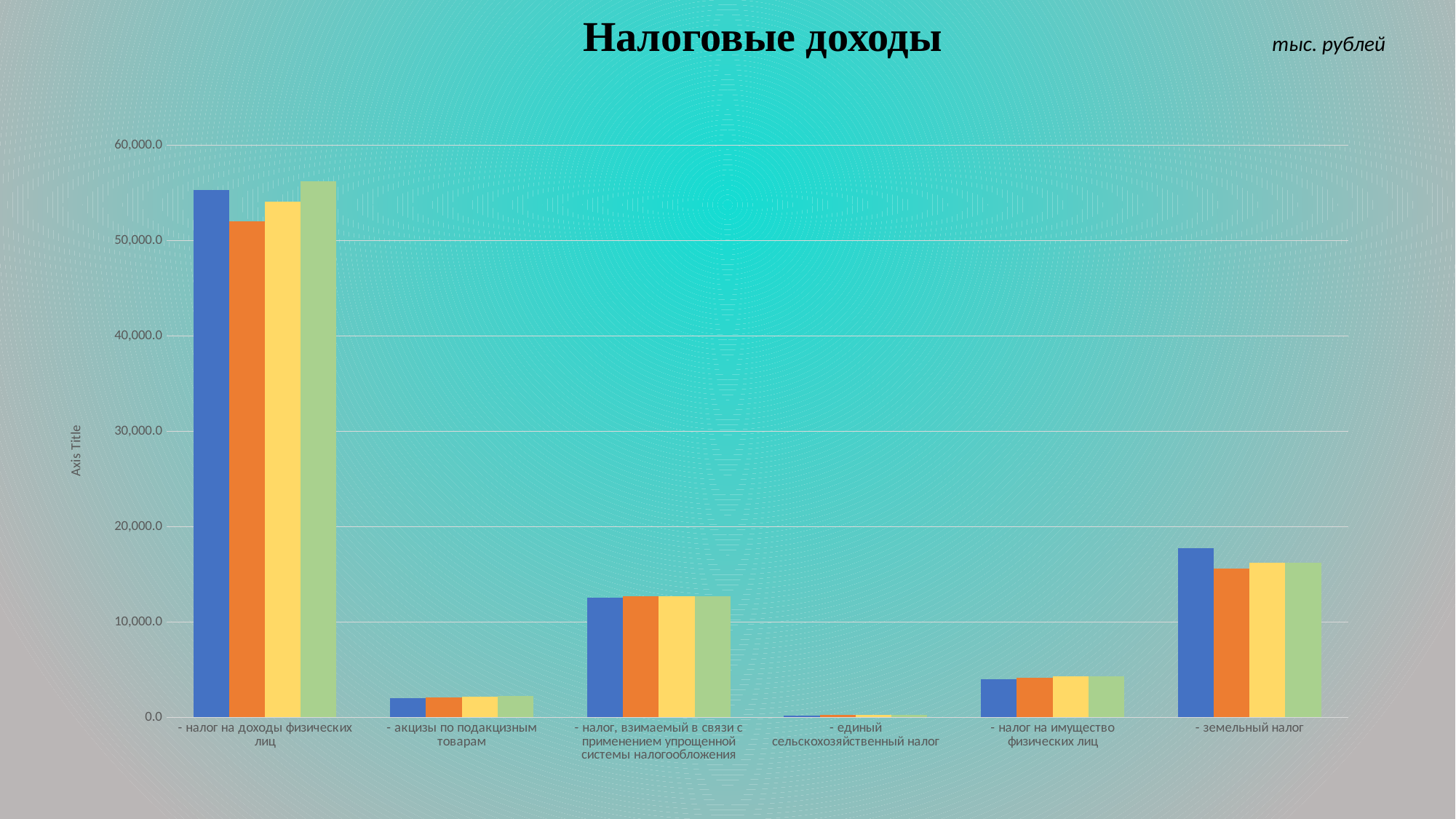
Is the value of the blue bar for 'налог на доходы физических лиц' greater or less than 50,000.0? greater How many categories are shown on the x axis? 6 What kind of chart is shown on the slide? bar chart What unit is indicated for the values on the slide? тыс. рублей Are the bars for 'налог, взимаемый в связи с применением упрощенной системы налогообложения' greater or less than 10,000.0? greater What is the title of the chart? Налоговые доходы Is the value of the blue bar for 'земельный налог' greater or less than 20,000.0? less Which category has larger values: 'земельный налог' or 'налог на имущество физических лиц'? земельный налог How many bars are plotted for each category? 4 Which category has the highest values? налог на доходы физических лиц Which category has the lowest values? единый сельскохозяйственный налог